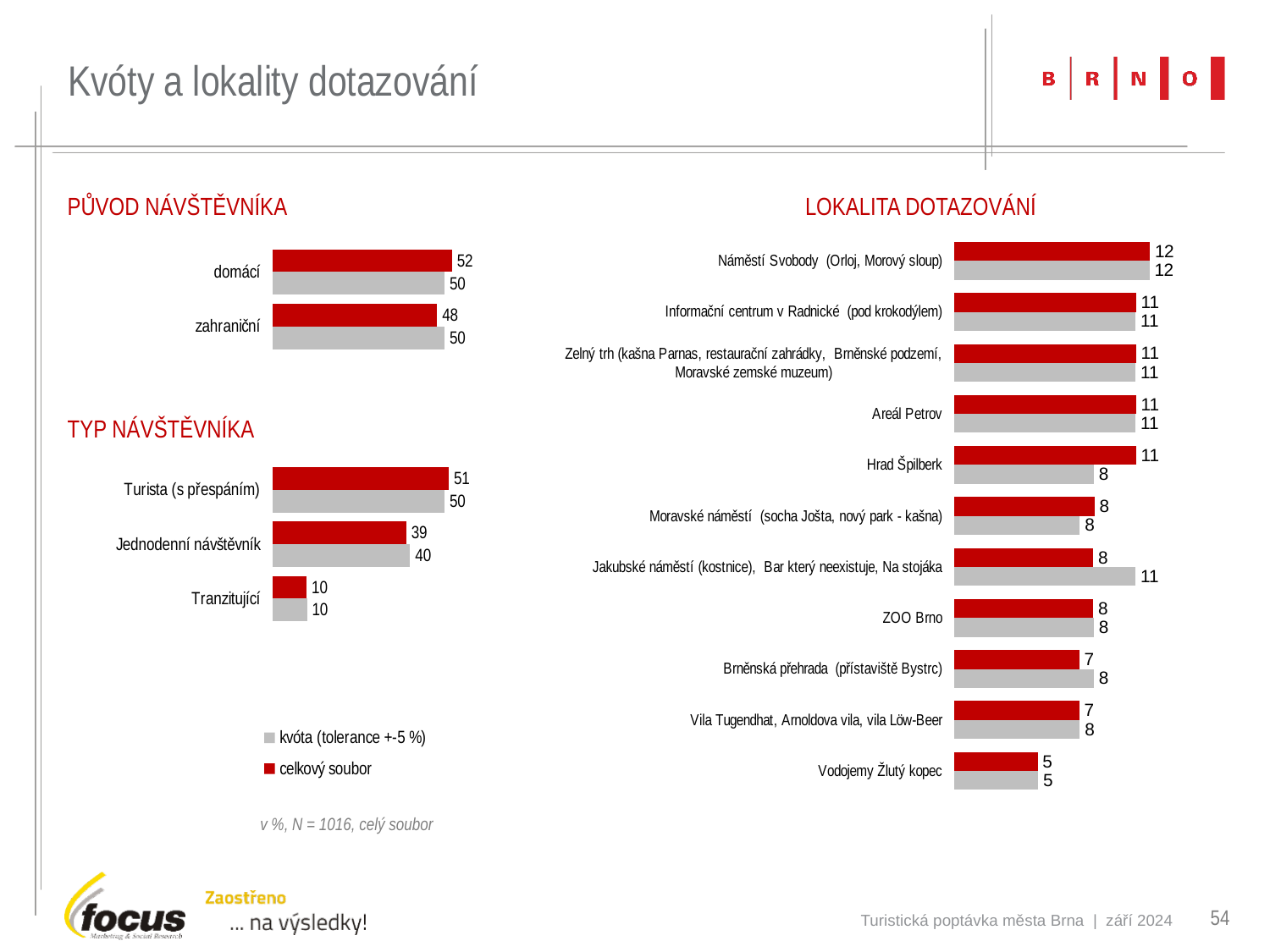
In the LOKALITA DOTAZOVÁNÍ chart, what is the kvóta value for Jakubské náměstí (kostnice), Bar který neexistuje, Na stojáka? 11 How many series does the legend on the slide list? 2 In the TYP NÁVŠTĚVNÍKA chart, which category has the lowest celkový soubor value? Tranzitující In the PŮVOD NÁVŠTĚVNÍKA chart, what is the kvóta value for zahraniční? 50 How many categories does the TYP NÁVŠTĚVNÍKA chart show? 3 In the PŮVOD NÁVŠTĚVNÍKA chart, what is the difference between the celkový soubor values for domácí and zahraniční? 4 In the PŮVOD NÁVŠTĚVNÍKA chart, what is the celkový soubor value for domácí? 52 In the LOKALITA DOTAZOVÁNÍ chart, which location has the highest celkový soubor value? Náměstí Svobody (Orloj, Morový sloup) In the LOKALITA DOTAZOVÁNÍ chart, which location has the lowest celkový soubor value? Vodojemy Žlutý kopec In the LOKALITA DOTAZOVÁNÍ chart, what is the celkový soubor value for Hrad Špilberk? 11 How many locations does the LOKALITA DOTAZOVÁNÍ chart list? 11 In the TYP NÁVŠTĚVNÍKA chart, what is the celkový soubor value for Jednodenní návštěvník? 39